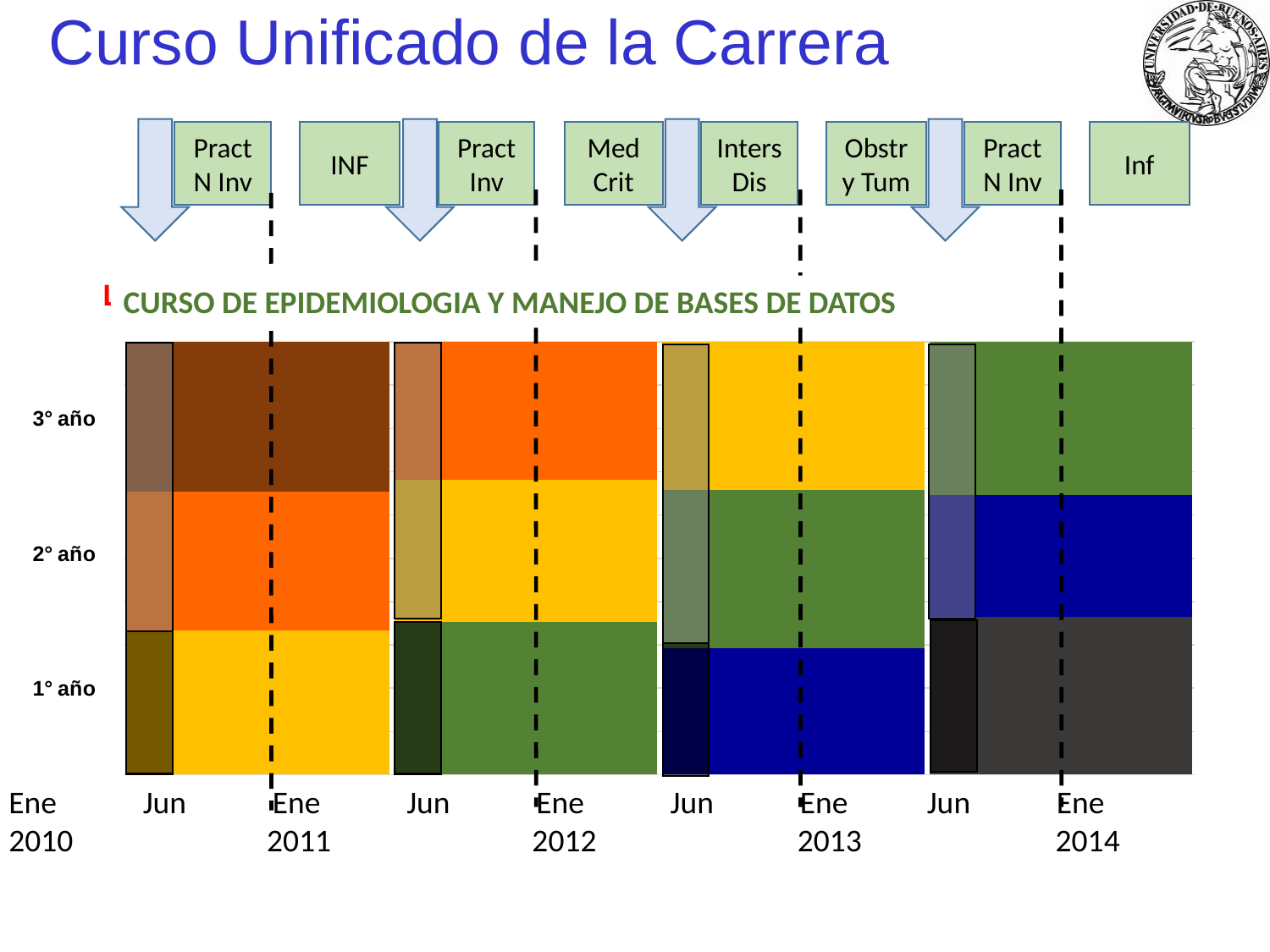
What is the first label on the chart's horizontal axis? Ene 2010 Which year level is labeled in the middle of the vertical axis? 2° año How many year levels (años) are labeled on the vertical axis of the chart? 3 What is the last label on the chart's horizontal axis? Ene 2014 How many stacked bars are drawn in the chart? 4 Which year level is labeled at the bottom of the vertical axis? 1° año What kind of chart is shown on the slide? stacked bar chart Which year level is labeled at the top of the vertical axis? 3° año